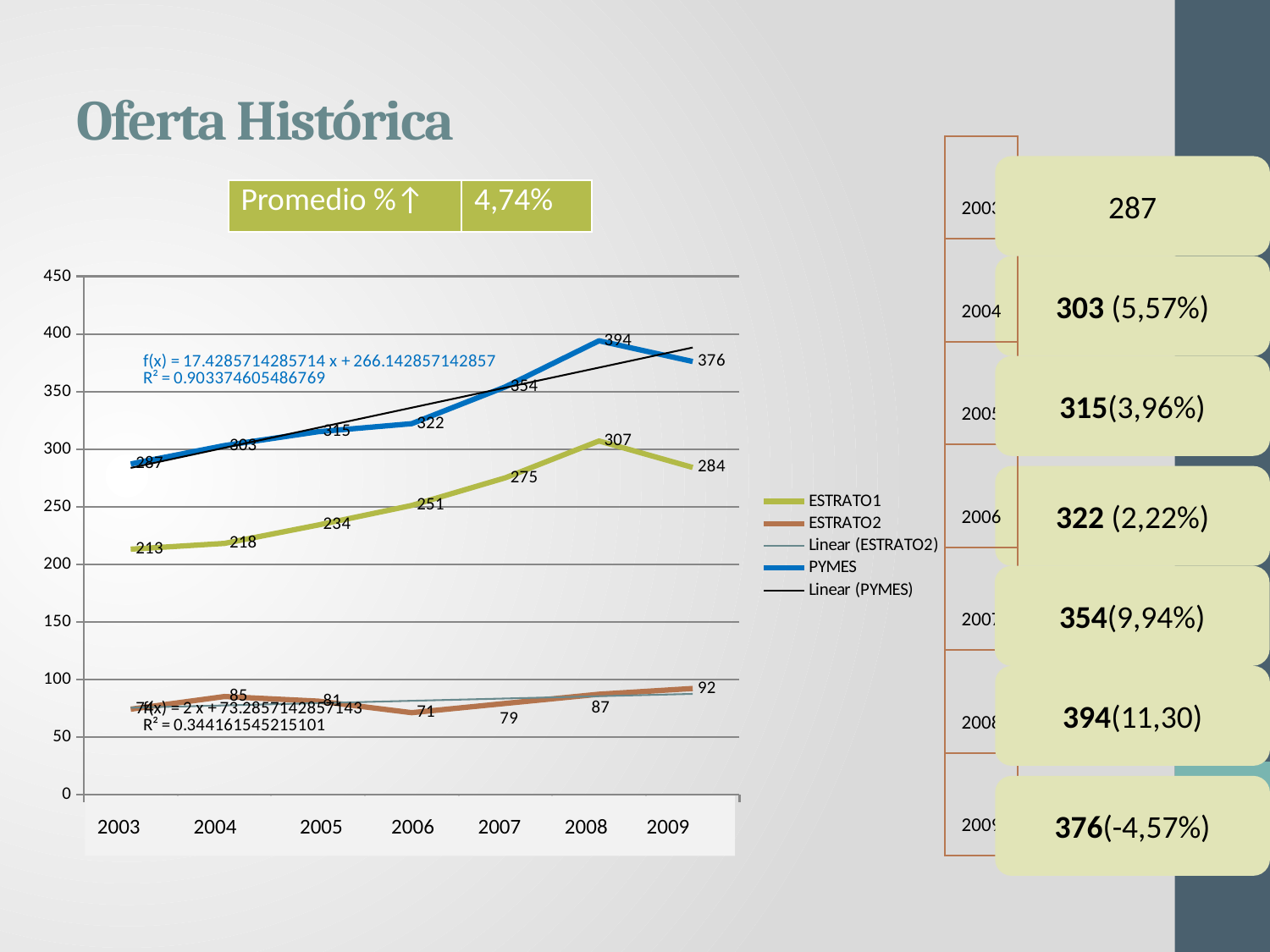
What is the difference between the PYMES value in 2009 and the ESTRATO1 value in 2009? 92 How many years are shown on the x axis? 7 Which is larger in 2007: the PYMES value or the ESTRATO1 value? PYMES What is the value of PYMES in 2008? 394 What is the value of ESTRATO2 in 2009? 92 In which year does PYMES reach its highest value? 2008 What is the value of ESTRATO1 in 2006? 251 In which year is ESTRATO1 at its lowest value? 2003 What type of chart is shown on the slide? line chart How many entries does the legend list? 5 Does the PYMES series rise or fall from 2003 to 2008? rise Is the value of ESTRATO1 in 2008 greater or less than 300? greater